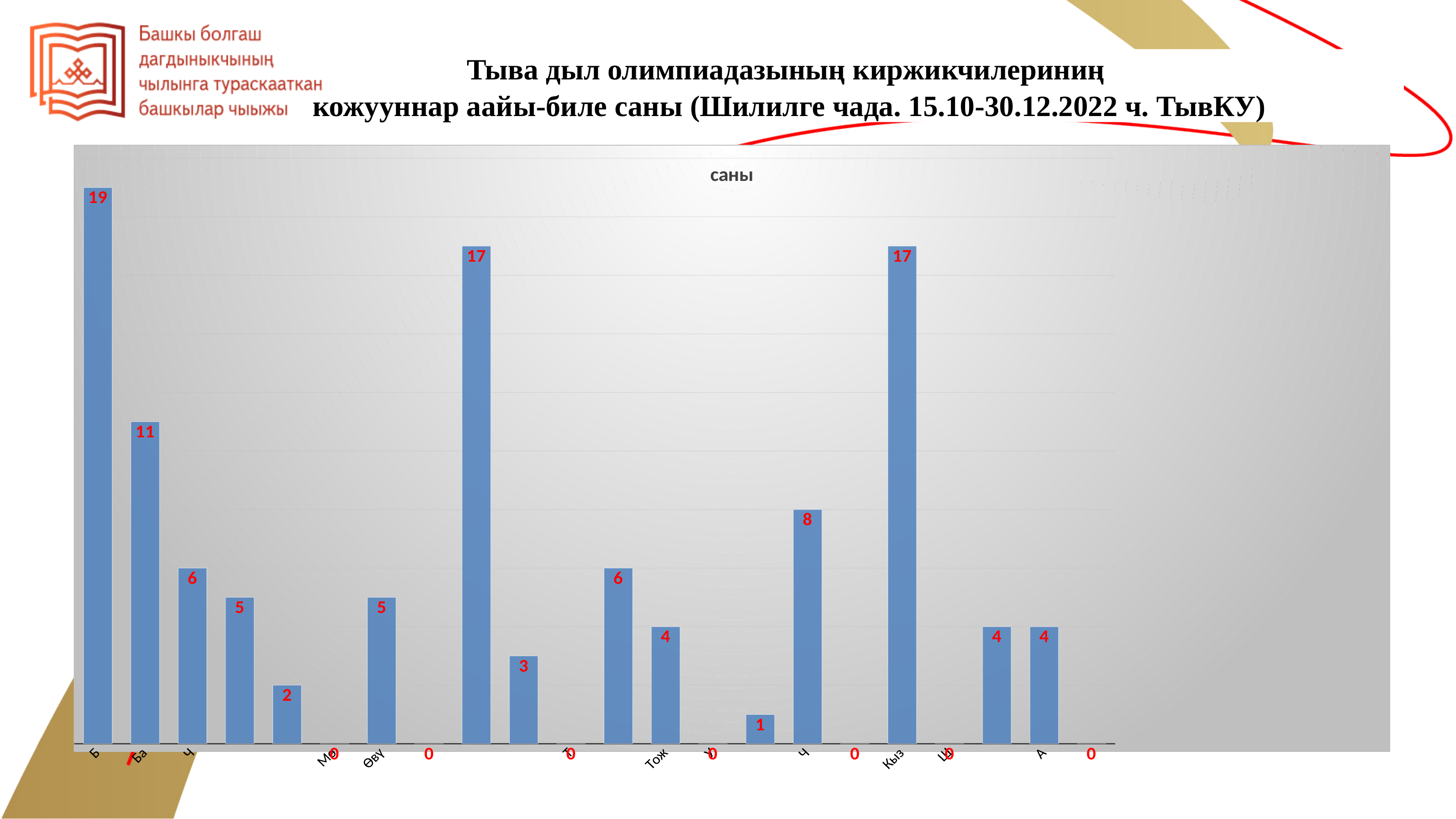
What is the value of the bar for the category labelled 'Кыз'? 17 What colour are the bars in the chart? blue What is the lowest value labelled in the chart? 0 How many data labels in the chart show the value 0? 7 What is the title shown inside the chart area? саны What is the difference between the highest value (19) and the value for 'Кыз'? 2 Which is larger, the value for 'Кыз' or the value for 'Тож'? Кыз What is the highest value shown in the chart? 19 What is the value of the bar for the category labelled 'Тож'? 4 How many bars in the chart have the value 17? 2 What type of chart is shown on the slide? bar chart What is the value of the bar for the category labelled 'Өвү'? 5